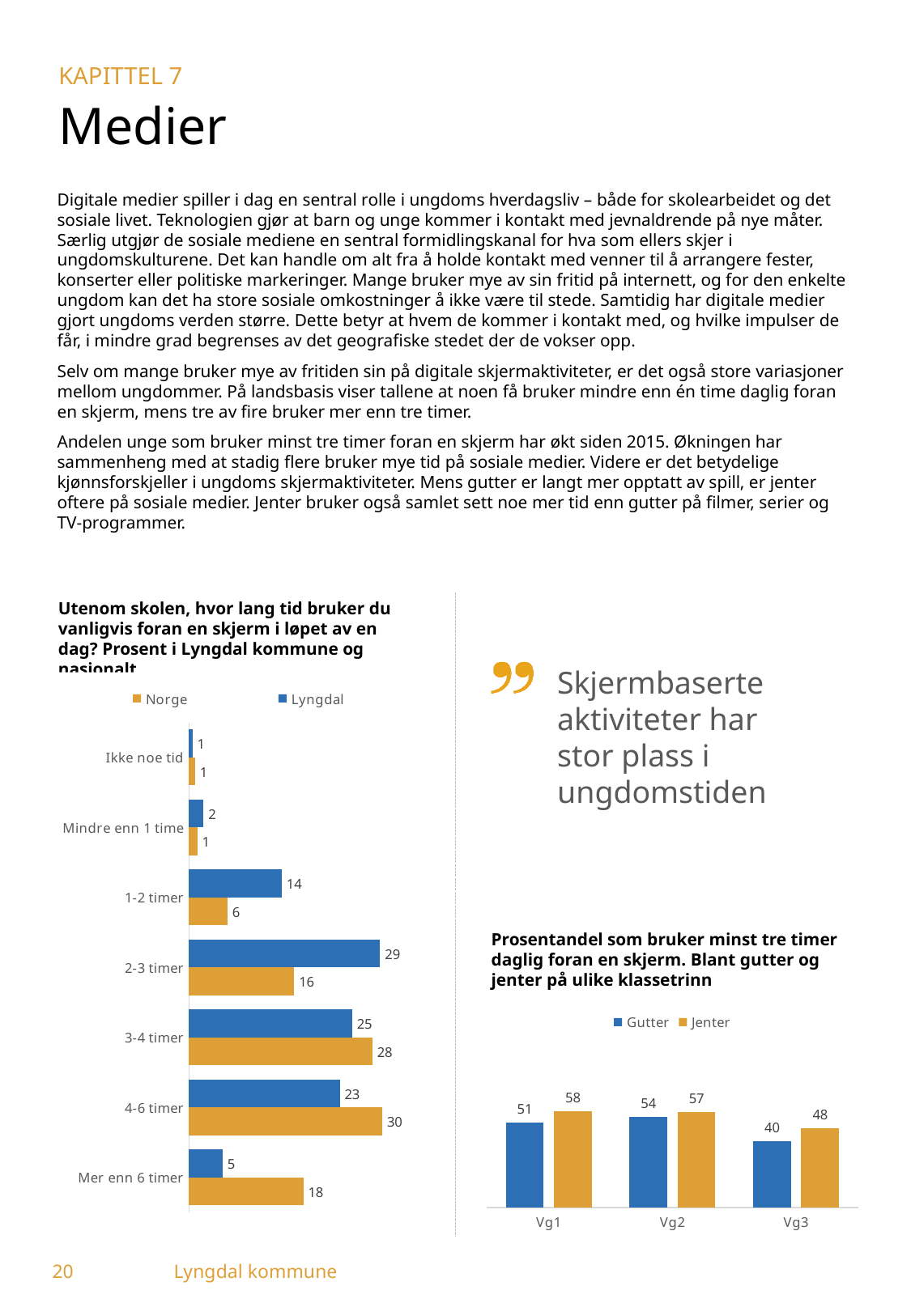
In the left chart (Utenom skolen, hvor lang tid bruker du vanligvis foran en skjerm), which category has the highest Norge value? 4-6 timer In the left chart (Utenom skolen, hvor lang tid bruker du vanligvis foran en skjerm), how many categories are shown? 7 In the left chart (Utenom skolen, hvor lang tid bruker du vanligvis foran en skjerm), which is larger for 4-6 timer, Norge or Lyngdal? Norge In the right chart (Prosentandel som bruker minst tre timer daglig foran en skjerm), which class level has the lowest Gutter value? Vg3 In the left chart (Utenom skolen, hvor lang tid bruker du vanligvis foran en skjerm), how many series does the legend list? 2 In the right chart (Prosentandel som bruker minst tre timer daglig foran en skjerm), what is the Jenter value for Vg1? 58 In the left chart (Utenom skolen, hvor lang tid bruker du vanligvis foran en skjerm), what is the difference between the Lyngdal and Norge values for 1-2 timer? 8 In the left chart (Utenom skolen, hvor lang tid bruker du vanligvis foran en skjerm), which category has the highest Lyngdal value? 2-3 timer What kind of chart is the right chart (Prosentandel som bruker minst tre timer daglig foran en skjerm)? Bar chart In the right chart (Prosentandel som bruker minst tre timer daglig foran en skjerm), what is the difference between Jenter and Gutter for Vg3? 8 In the left chart (Utenom skolen, hvor lang tid bruker du vanligvis foran en skjerm), what is the Norge value for Mer enn 6 timer? 18 In the left chart (Utenom skolen, hvor lang tid bruker du vanligvis foran en skjerm), what is the Lyngdal value for 2-3 timer? 29